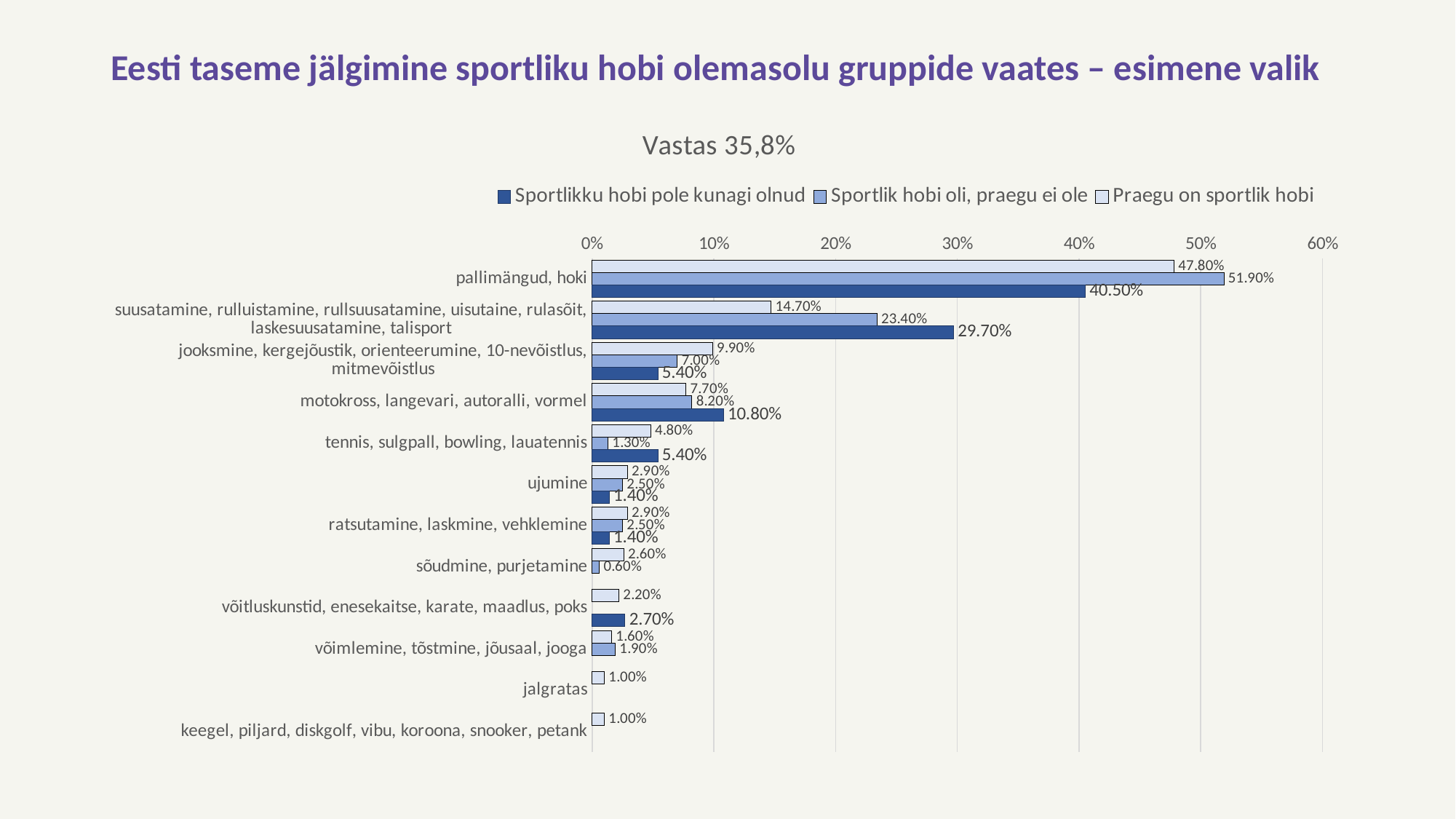
What is the value for 'jalgratas' in the series 'Praegu on sportlik hobi'? 1.00% What type of chart is shown on the slide? bar chart What is the value for 'suusatamine, rulluistamine, rullsuusatamine, uisutaine, rulasõit, laskesuusatamine, talisport' in the series 'Sportlikku hobi pole kunagi olnud'? 29.70% For 'tennis, sulgpall, bowling, lauatennis', which series has the larger value: 'Praegu on sportlik hobi' or 'Sportlik hobi oli, praegu ei ole'? Praegu on sportlik hobi Which category has the highest value in the series 'Sportlikku hobi pole kunagi olnud'? pallimängud, hoki How many categories are shown on the vertical axis of the chart? 12 Is the value for 'pallimängud, hoki' in the series 'Praegu on sportlik hobi' greater or less than 40%? greater How many series does the legend list? 3 What is the difference between the 'Sportlik hobi oli, praegu ei ole' and 'Sportlikku hobi pole kunagi olnud' values for 'pallimängud, hoki'? 11.40% What is the value for 'motokross, langevari, autoralli, vormel' in the series 'Praegu on sportlik hobi'? 7.70% What is the value for 'pallimängud, hoki' in the series 'Sportlik hobi oli, praegu ei ole'? 51.90% What is the title of the chart? Vastas 35,8%